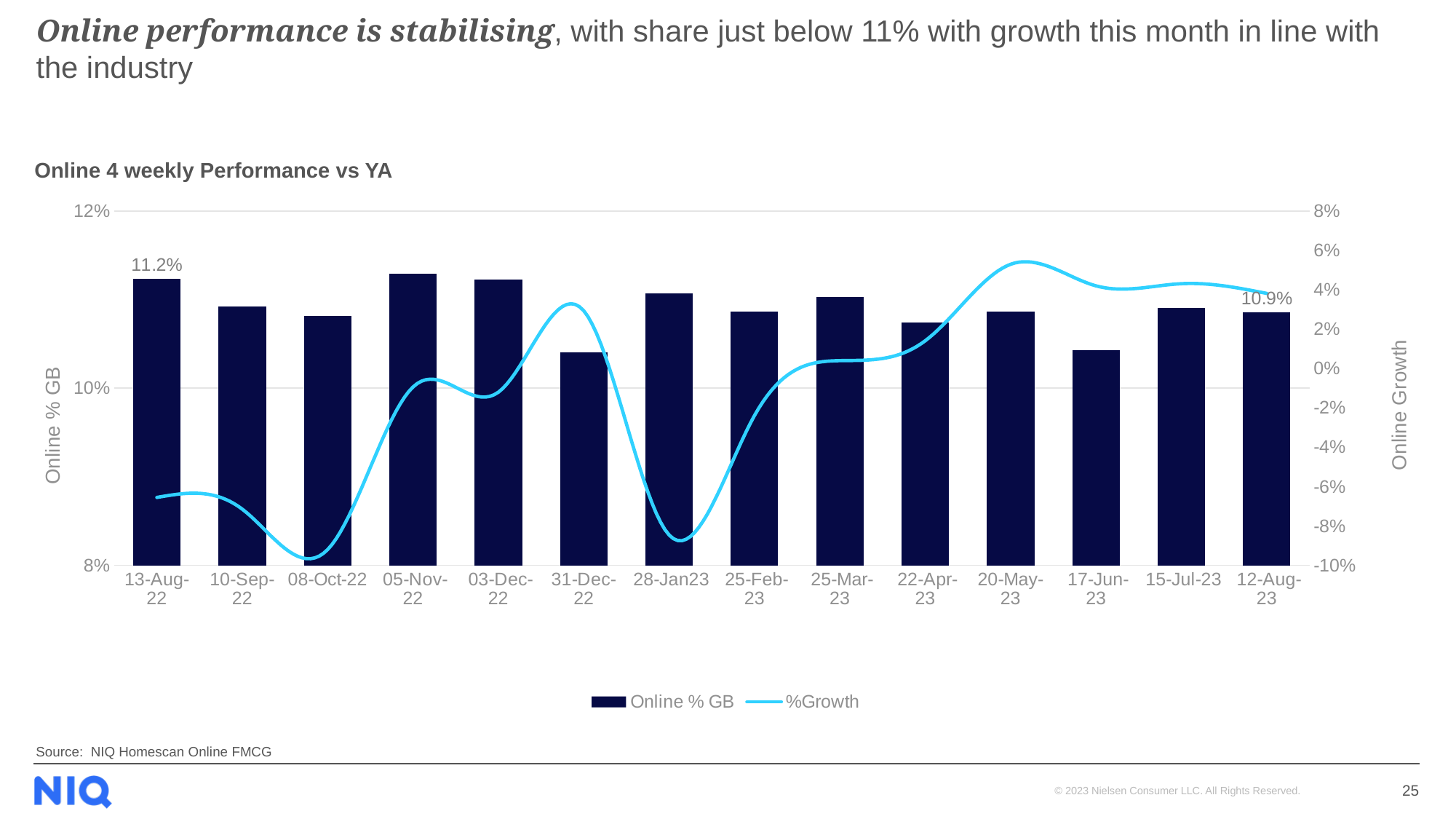
How many series does the legend list? 2 What is the Online % GB value for 13-Aug-22? 11.2% Is the %Growth value for 20-May-23 greater or less than 4%? greater What is the Online % GB value for 12-Aug-23? 10.9% What is the title of the chart? Online 4 weekly Performance vs YA Is the %Growth value for 08-Oct-22 greater or less than -8%? less What kind of chart is shown on the slide? A combination bar and line chart How many 4-weekly periods are shown on the x axis? 14 Which has the higher Online % GB value, 13-Aug-22 or 12-Aug-23? 13-Aug-22 Does the %Growth line end higher or lower at 12-Aug-23 than it starts at 13-Aug-22? higher Is the Online % GB value for 31-Dec-22 greater or less than 10%? greater What is the difference between the Online % GB values for 13-Aug-22 and 12-Aug-23? 0.3 percentage points